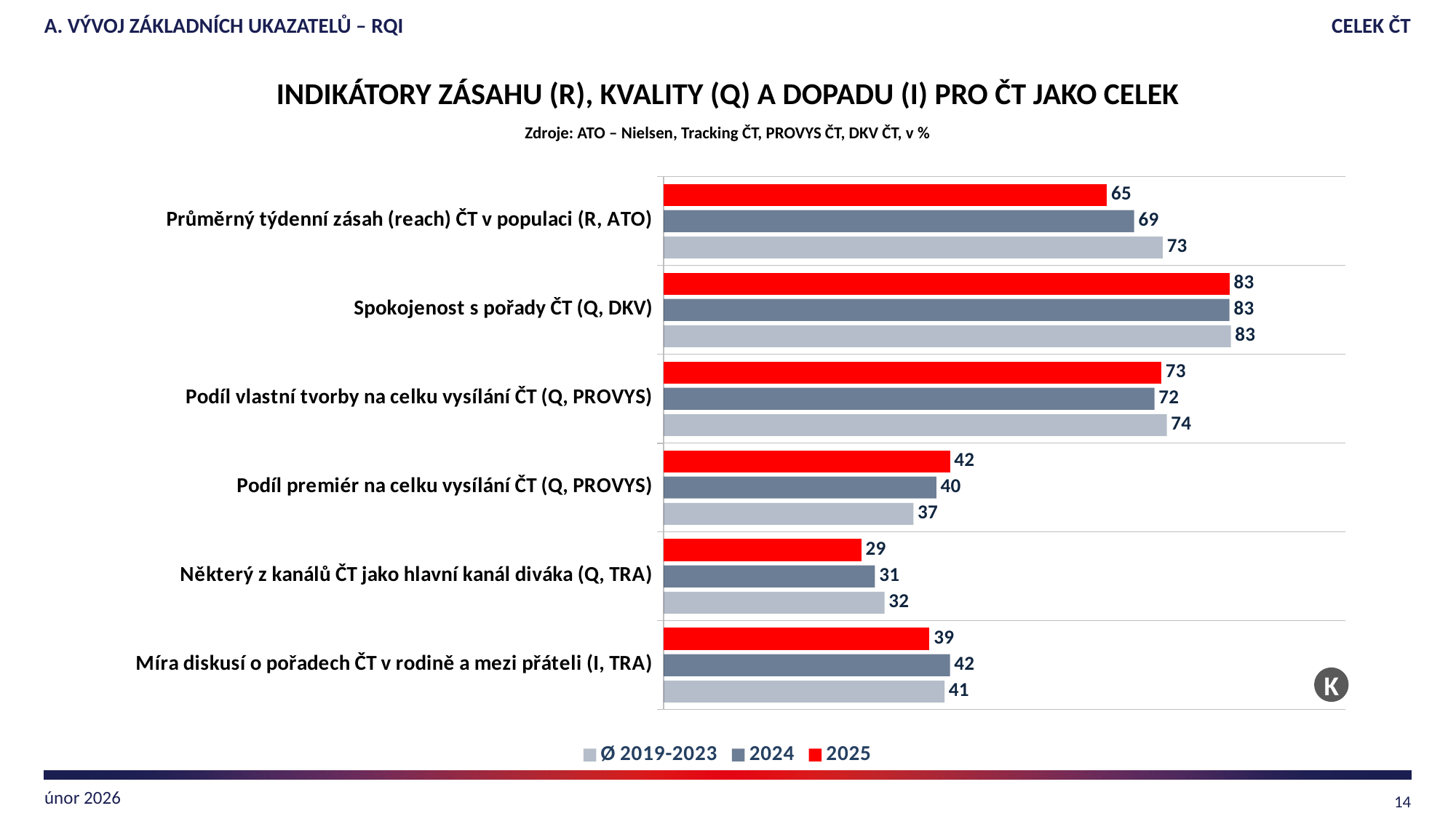
How many series does the legend list? 3 What is the 2024 value for Míra diskusí o pořadech ČT v rodině a mezi přáteli (I, TRA)? 42 Which category has the lowest 2025 value? Některý z kanálů ČT jako hlavní kanál diváka (Q, TRA) For Podíl premiér na celku vysílání ČT (Q, PROVYS), which is larger: the 2024 value or the 2025 value? 2025 What is the Ø 2019-2023 value for Podíl premiér na celku vysílání ČT (Q, PROVYS)? 37 What kind of chart is shown on the slide? Bar chart What is the difference between the Ø 2019-2023 and 2025 values for Průměrný týdenní zásah (reach) ČT v populaci (R, ATO)? 8 What is the 2025 value for Průměrný týdenní zásah (reach) ČT v populaci (R, ATO)? 65 Which series is shown in red in the legend? 2025 How many categories are shown on the chart? 6 Which category has the highest 2025 value? Spokojenost s pořady ČT (Q, DKV) What is the title of the chart? INDIKÁTORY ZÁSAHU (R), KVALITY (Q) A DOPADU (I) PRO ČT JAKO CELEK